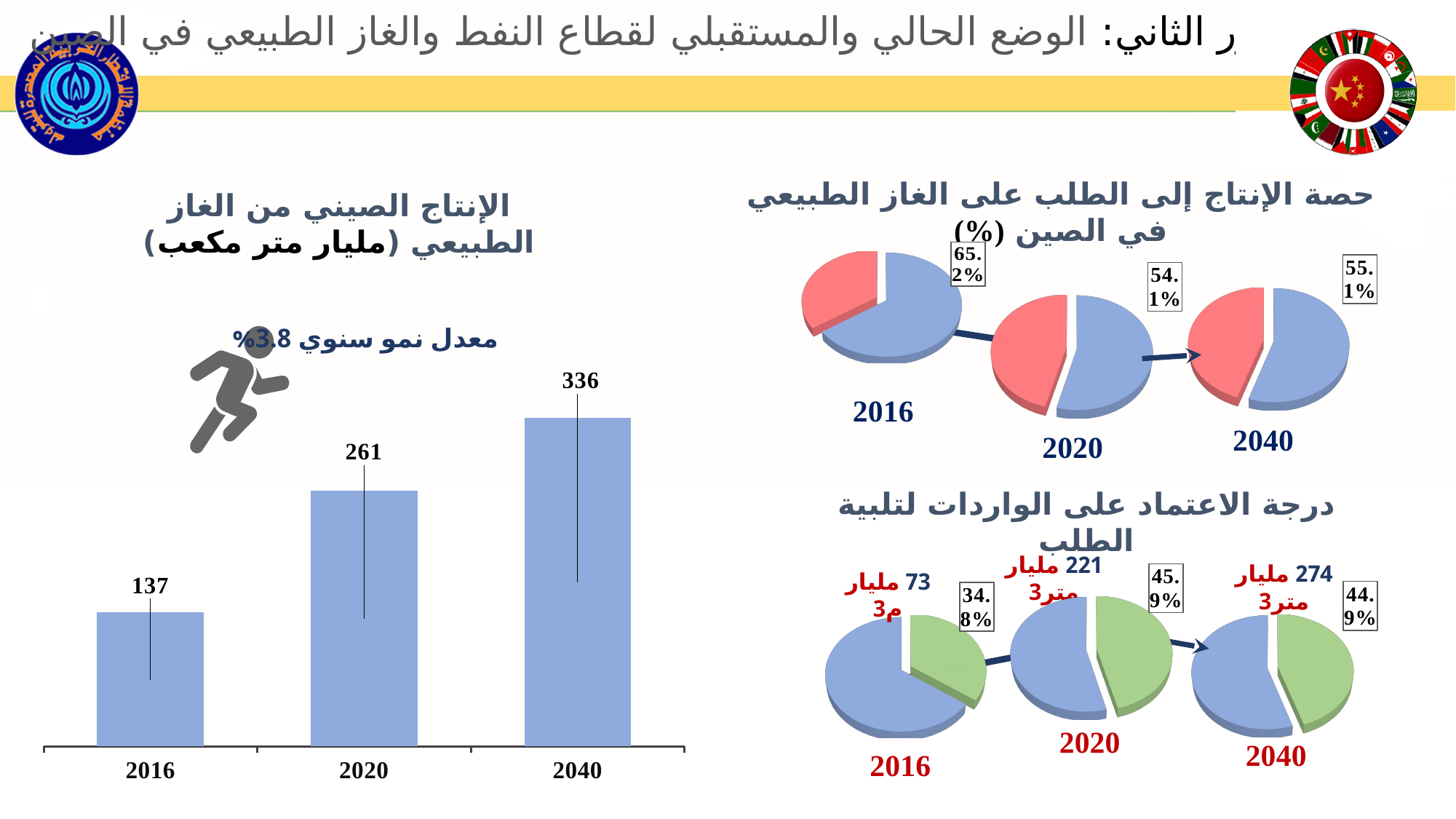
In the bar chart on the left (Chinese natural gas production), what is the difference between the 2040 and 2020 values? 75 What type of chart is used on the left for Chinese natural gas production? bar chart What annual growth rate is annotated on the bar chart on the left? 3.8% In the top-right pie charts (share of production to natural gas demand in China), which year has the lowest share? 2020 In the bottom-right pie charts (degree of dependence on imports), which is larger: the 2016 percentage or the 2040 percentage? 2040 In the bar chart on the left (Chinese natural gas production), do the values rise or fall from 2016 to 2040? rise In the bar chart on the left (Chinese natural gas production, billion cubic metres), what is the value for 2016? 137 In the bottom-right pie charts (degree of dependence on imports to meet demand), what is the percentage for 2020? 45.9% In the top-right pie charts (share of production to natural gas demand in China), what is the share for 2016? 65.2% In the bar chart on the left (Chinese natural gas production), how many years are plotted? 3 In the bar chart on the left (Chinese natural gas production), what is the value for 2040? 336 In the bar chart on the left (Chinese natural gas production), which year has the lowest value? 2016